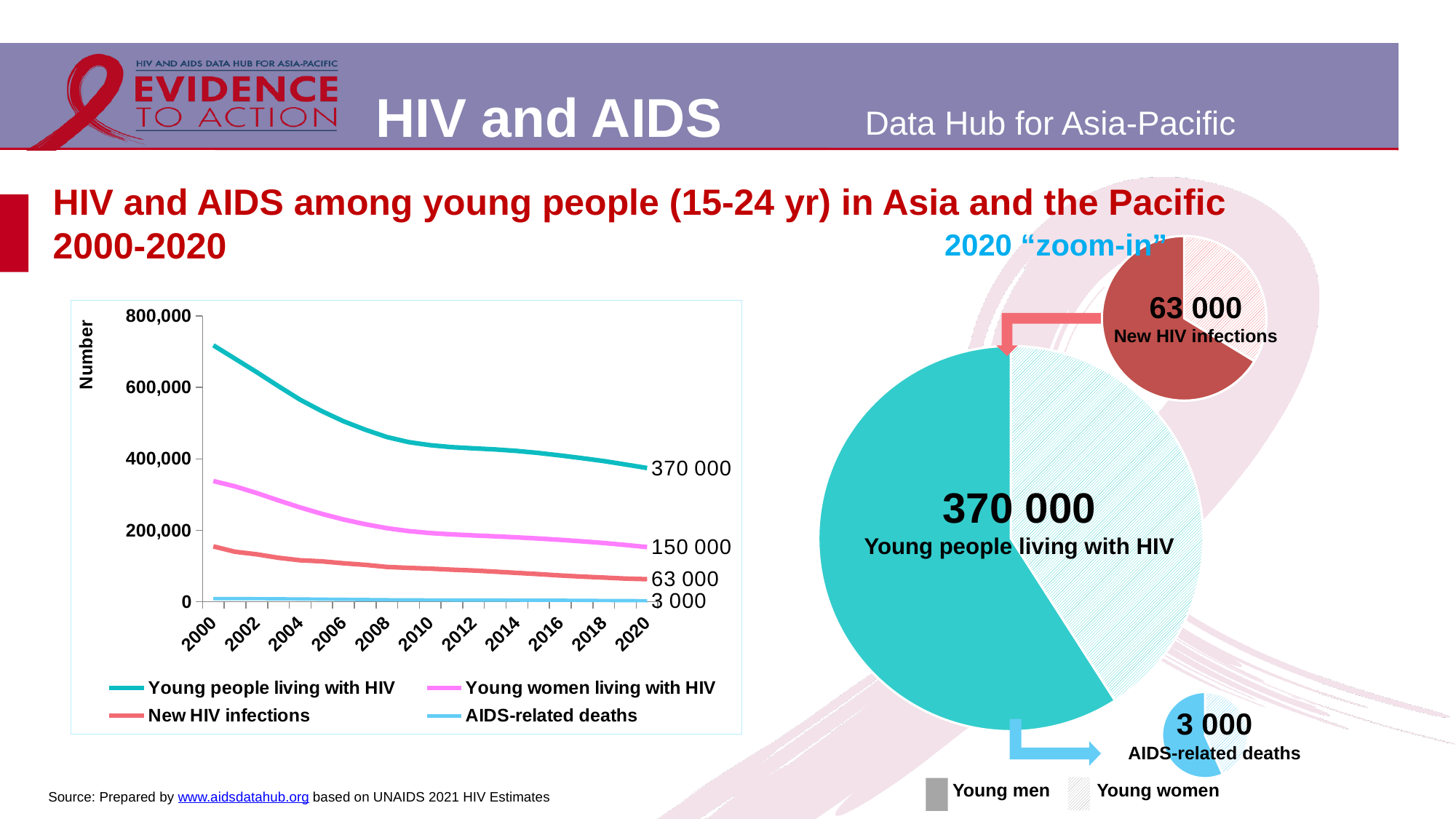
In the line chart, is the value for Young people living with HIV in 2000 greater or less than 600,000? greater In the 2020 "zoom-in" pie charts, what two groups does the legend list? Young men and Young women What kind of chart is the chart on the left of the slide? Line chart In the line chart, what is the value for AIDS-related deaths in 2020? 3 000 In the line chart, what is the difference between Young people living with HIV and Young women living with HIV in 2020? 220 000 In the line chart, is the value for Young women living with HIV in 2000 greater or less than 400,000? less In the line chart, does the Young people living with HIV series rise or fall from 2000 to 2020? Fall In the line chart, what is the value for Young people living with HIV in 2020? 370 000 In the line chart, what is the value for New HIV infections in 2020? 63 000 In the line chart, what is the value for Young women living with HIV in 2020? 150 000 In the line chart, which series has the highest value in 2020? Young people living with HIV How many series does the legend of the line chart list? 4